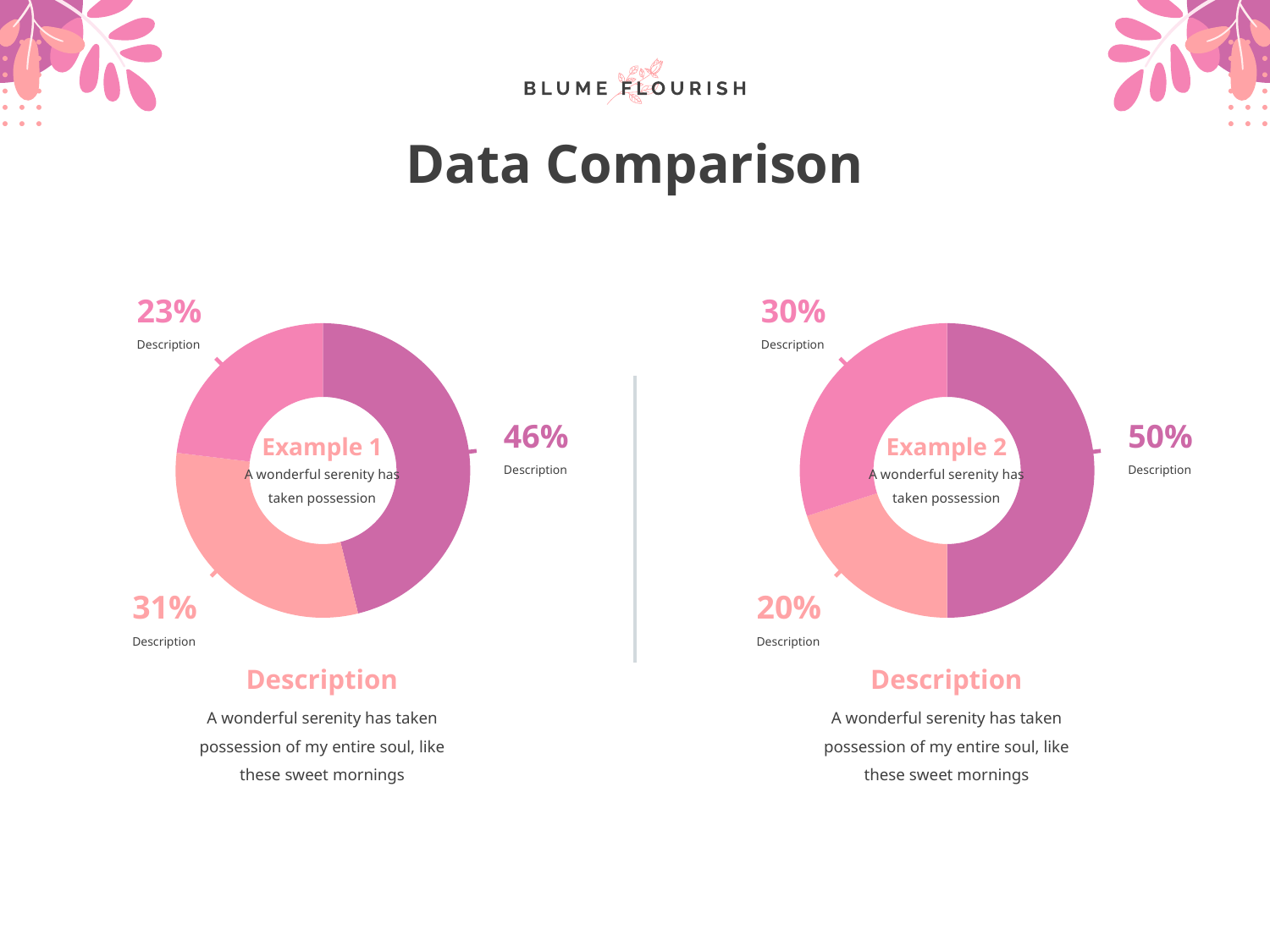
In the 'Example 1' chart, what is the value of the largest slice? 46% What kind of chart is the 'Example 1' chart on the left? Donut (pie) chart What is the total of the three slice values in the 'Example 2' chart? 100% In the 'Example 1' chart, what is the difference between the largest slice (46%) and the smallest slice (23%)? 23 percentage points Which chart has the larger dark magenta slice, 'Example 1' or 'Example 2'? Example 2 What is the title of the slide containing the two donut charts? Data Comparison In the 'Example 2' chart, what is the value of the light salmon slice at the bottom left? 20% In the 'Example 1' chart, what is the value of the smallest slice? 23% How many slices does the 'Example 1' donut chart have? 3 In the 'Example 2' chart, what is the value of the largest slice? 50% In the 'Example 2' chart, what is the value of the smallest slice? 20% In the 'Example 1' chart, what is the value of the dark magenta slice on the right? 46%